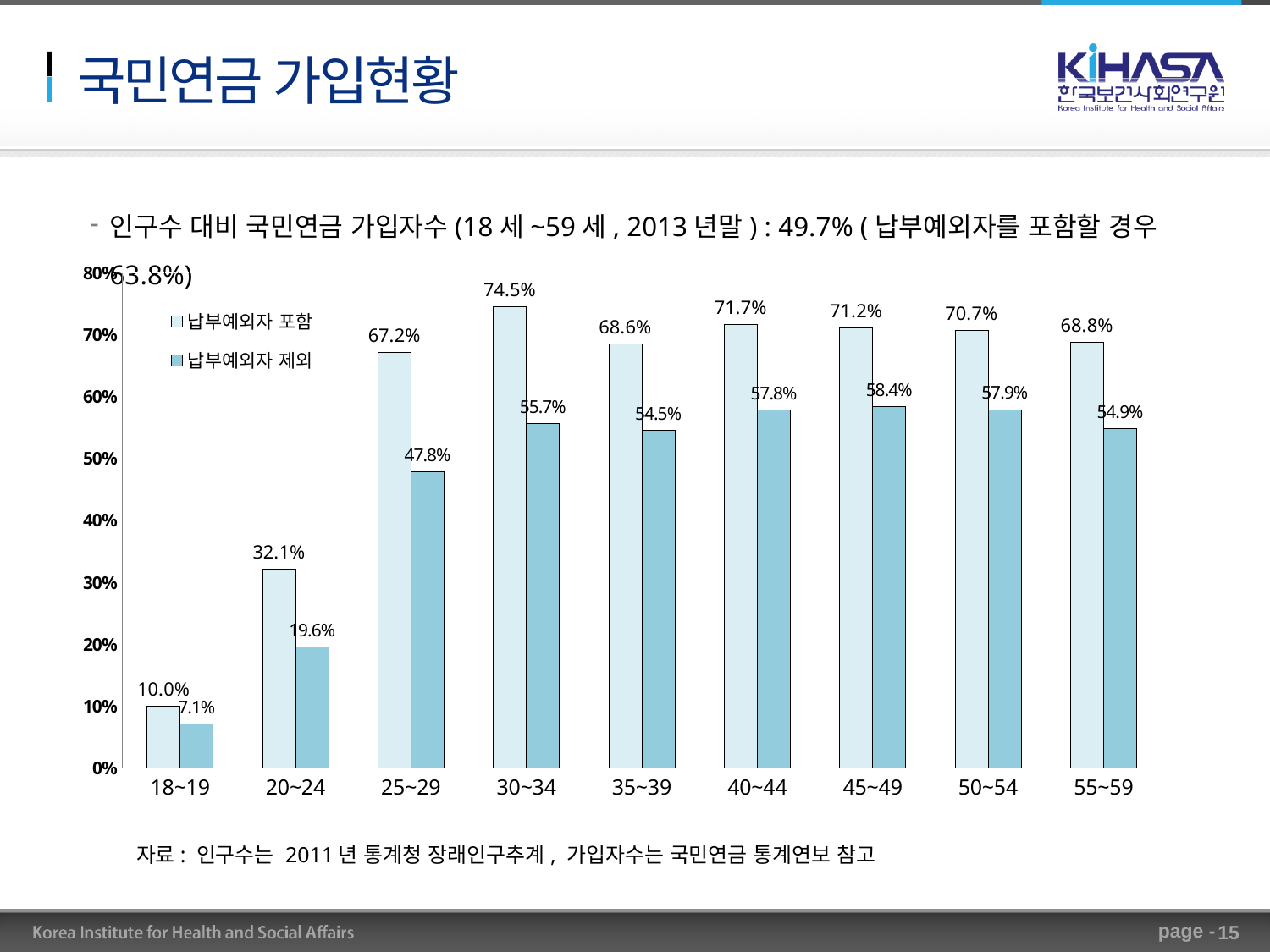
What is the value for the 25~29 age group in the 납부예외자 제외 series? 47.8% Is the 납부예외자 포함 value for the 20~24 age group greater or less than 40%? less Which age group has the highest value in the 납부예외자 포함 series? 30~34 How many age groups are shown on the x axis? 9 How many series does the legend list? 2 What are the two legend entries of the chart? 납부예외자 포함, 납부예외자 제외 What kind of chart is shown on the slide? bar chart What is the value for the 18~19 age group in the 납부예외자 제외 series? 7.1% Which is larger: the 납부예외자 제외 value for 45~49 or for 55~59? 45~49 Which age group has the lowest value in the 납부예외자 제외 series? 18~19 What is the value for the 30~34 age group in the 납부예외자 포함 series? 74.5% What is the difference between the 납부예외자 포함 and 납부예외자 제외 values for the 20~24 age group? 12.5%